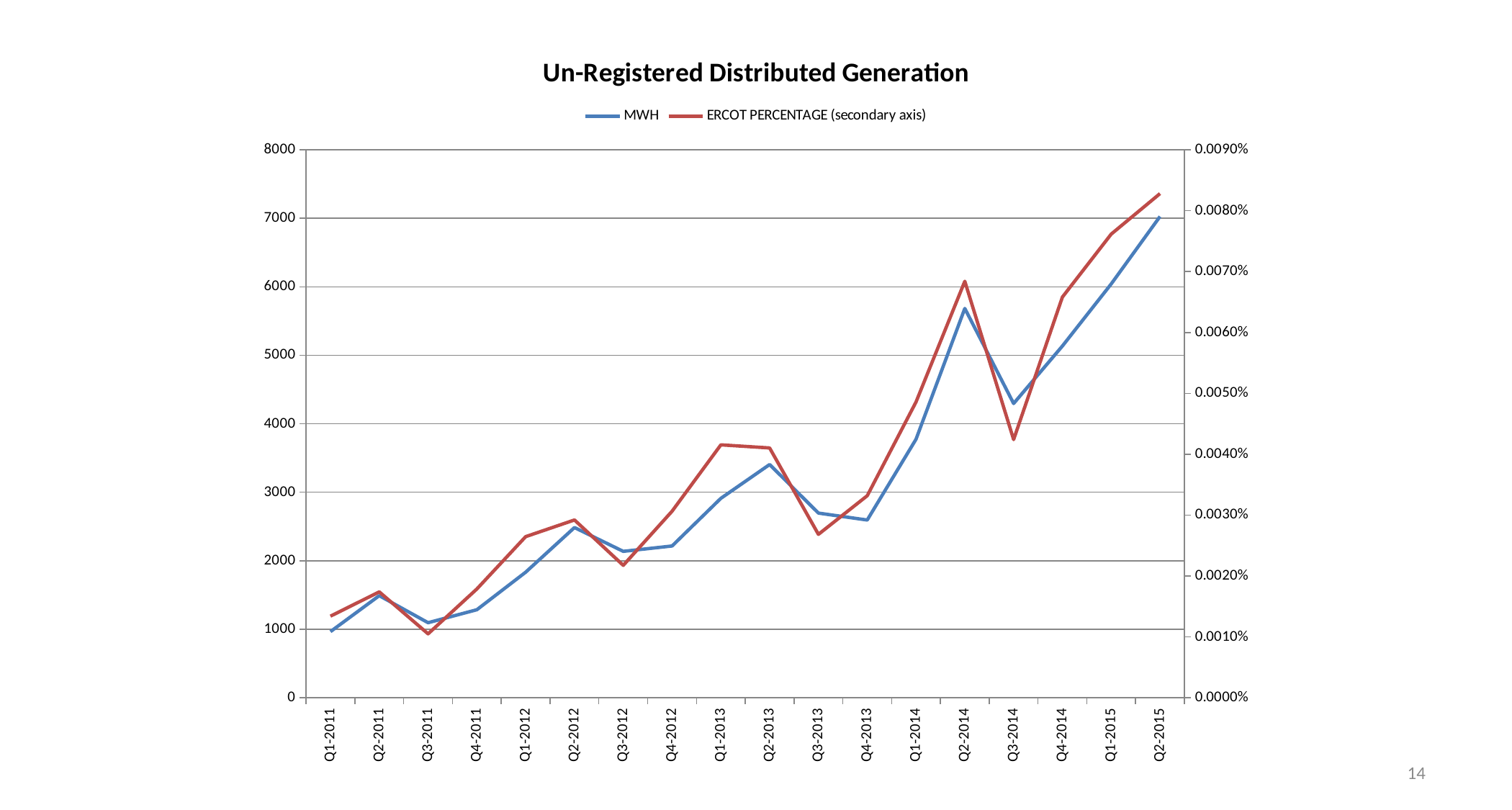
What kind of chart is shown on the slide? Line chart How many quarters are plotted along the x axis? 18 In which quarter is the MWH series at its lowest value? Q1-2011 Which quarter has the larger MWH value, Q2-2014 or Q3-2014? Q2-2014 How many series does the legend list? 2 In which quarter is the ERCOT PERCENTAGE series at its lowest value? Q3-2011 In which quarter does the MWH series reach its highest value? Q2-2015 Is the ERCOT PERCENTAGE value for Q3-2014 greater or less than 0.0050%? less What is the title of the chart? Un-Registered Distributed Generation Overall, do the MWH values rise or fall from Q1-2011 to Q2-2015? rise Is the MWH value for Q2-2014 greater or less than 5000? greater